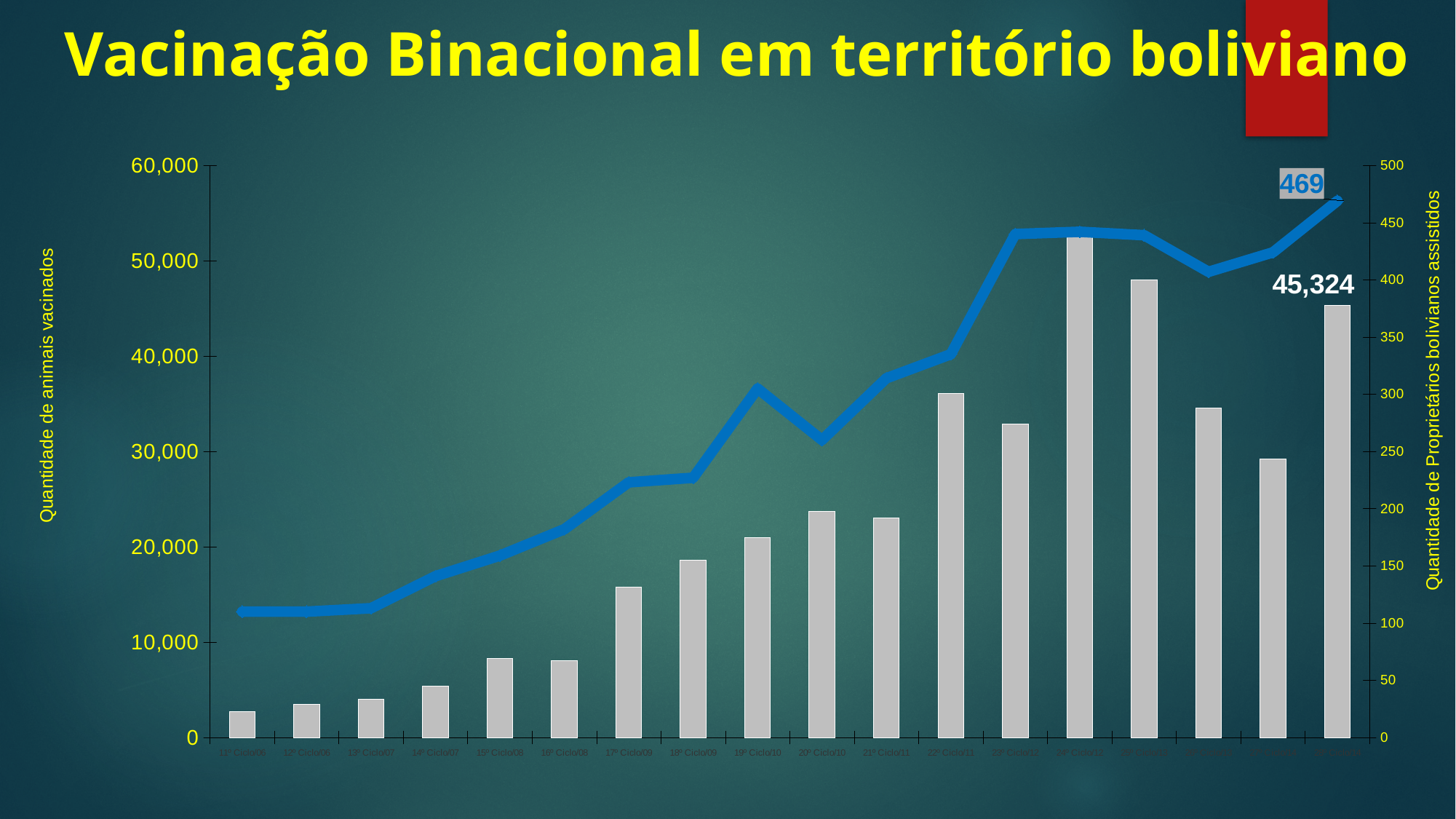
What value is printed on the data label of the rightmost bar? 45,324 Does the blue line generally rise or fall from left to right? Rise What is the title of the right vertical axis? Quantidade de Proprietários bolivianos assistidos What value is printed on the data label at the last point of the blue line? 469 Which is larger, the leftmost bar or the rightmost bar? The rightmost bar What is the title of the left vertical axis? Quantidade de animais vacinados On the right axis, is the first point of the blue line greater or less than 150? less What kind of chart is shown on the slide? Combination bar and line chart How many bars are plotted in the chart? 18 Is the value of the tallest bar greater or less than 50,000? greater Is the value of the rightmost bar greater or less than 40,000? greater